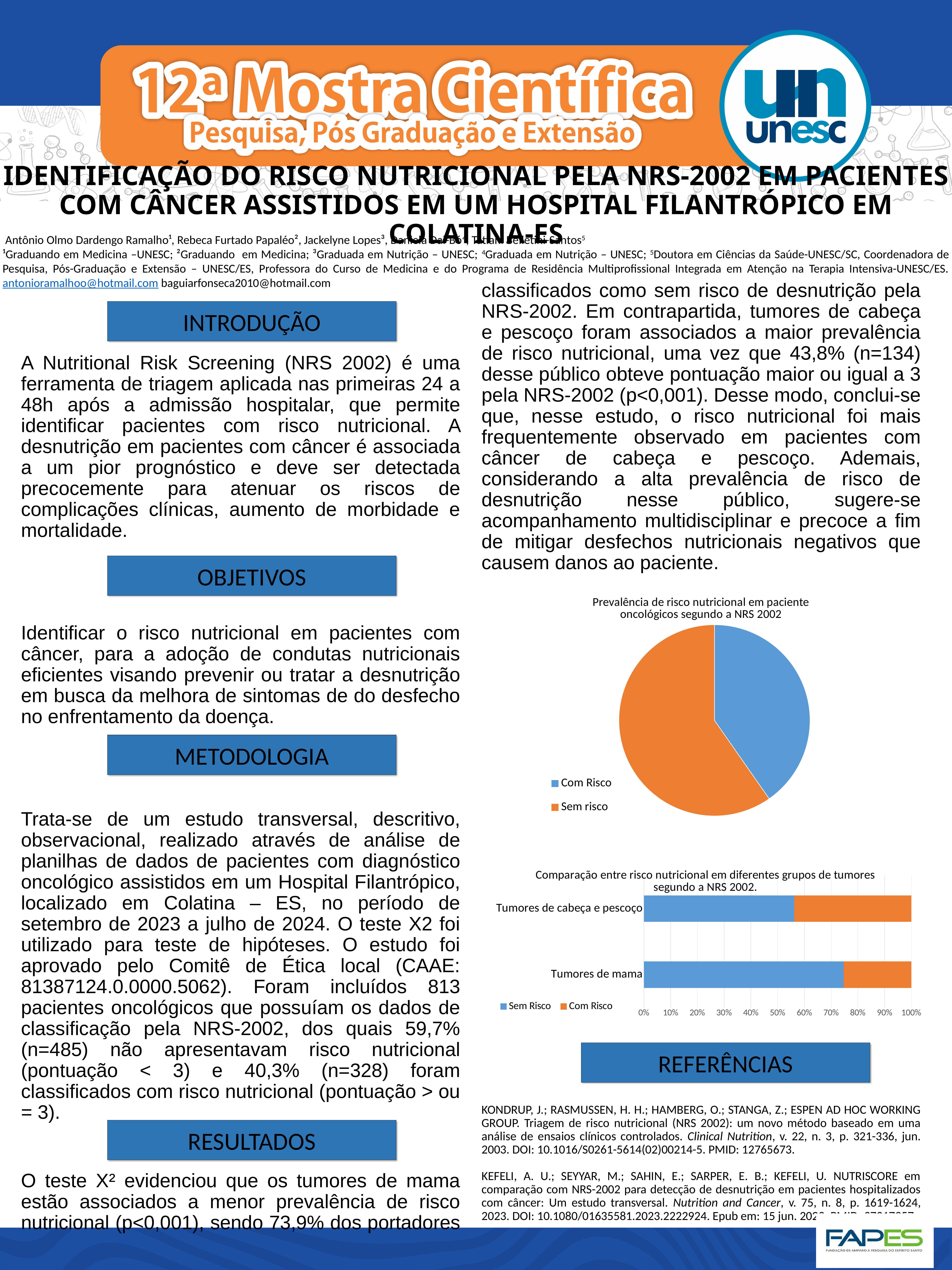
In the pie chart 'Prevalência de risco nutricional em paciente oncológicos segundo a NRS 2002', which slice is larger, 'Com Risco' or 'Sem risco'? Sem risco How many series does the legend of the bar chart 'Comparação entre risco nutricional em diferentes grupos de tumores segundo a NRS 2002' list? 2 In the bar chart 'Comparação entre risco nutricional em diferentes grupos de tumores segundo a NRS 2002', which tumour group has the larger 'Sem Risco' share? Tumores de mama How many tumour groups (categories) are shown in the bar chart 'Comparação entre risco nutricional em diferentes grupos de tumores segundo a NRS 2002'? 2 In the bar chart 'Comparação entre risco nutricional em diferentes grupos de tumores segundo a NRS 2002', is the 'Sem Risco' share for 'Tumores de mama' greater or less than 70%? greater In the pie chart 'Prevalência de risco nutricional em paciente oncológicos segundo a NRS 2002', what colour is the 'Com Risco' slice? Blue How many entries does the legend of the pie chart 'Prevalência de risco nutricional em paciente oncológicos segundo a NRS 2002' list? 2 In the bar chart 'Comparação entre risco nutricional em diferentes grupos de tumores segundo a NRS 2002', is the 'Sem Risco' share for 'Tumores de cabeça e pescoço' greater or less than 50%? greater What kind of chart is the chart titled 'Comparação entre risco nutricional em diferentes grupos de tumores segundo a NRS 2002'? Bar chart In the bar chart 'Comparação entre risco nutricional em diferentes grupos de tumores segundo a NRS 2002', is the 'Com Risco' share for 'Tumores de mama' greater or less than 40%? less In the bar chart 'Comparação entre risco nutricional em diferentes grupos de tumores segundo a NRS 2002', which tumour group has the larger 'Com Risco' share? Tumores de cabeça e pescoço What kind of chart is the chart titled 'Prevalência de risco nutricional em paciente oncológicos segundo a NRS 2002'? Pie chart